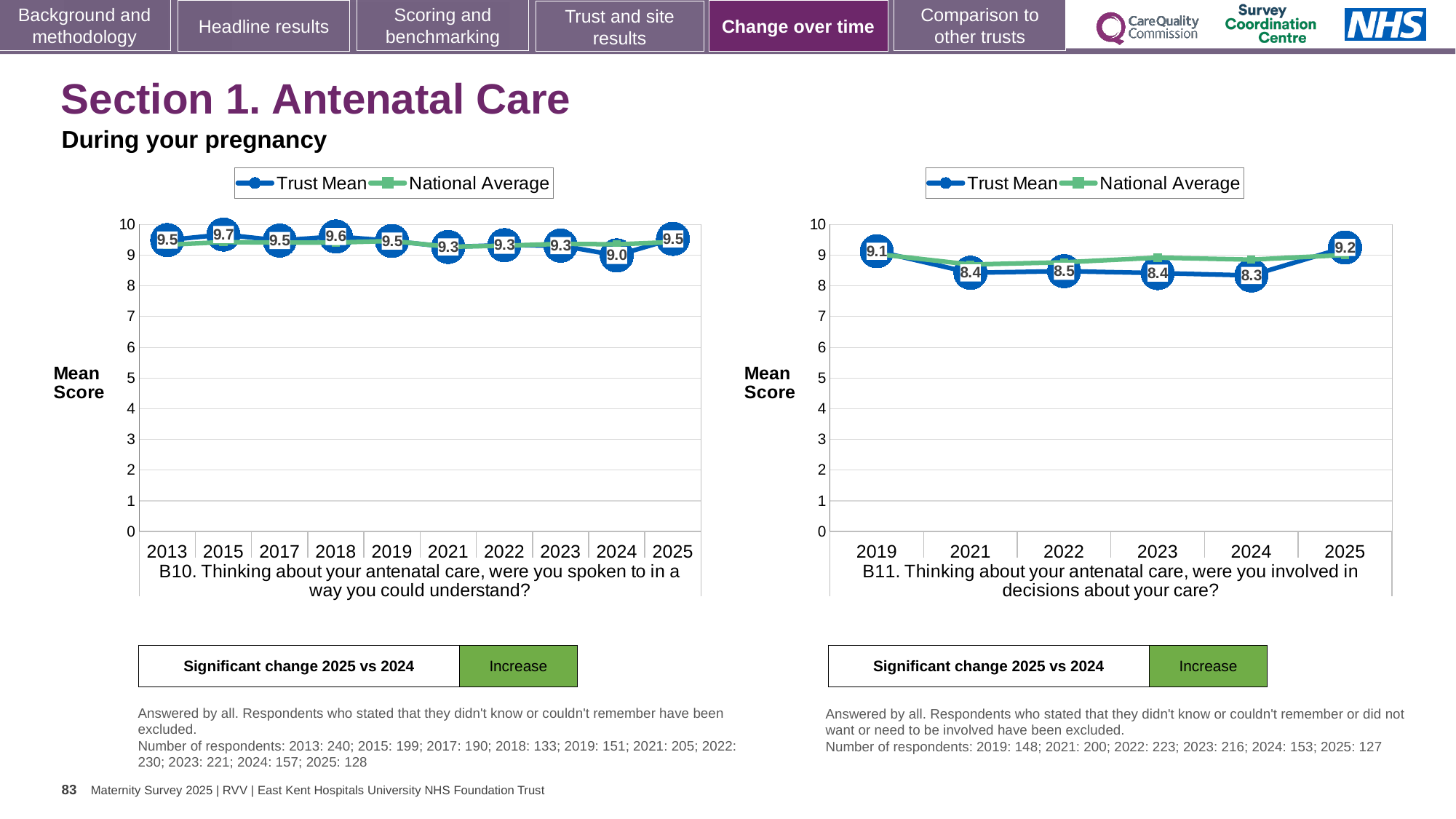
In the B11 chart on the right, which year has the lowest Trust Mean? 2024 In the B10 chart on the left, what is the Trust Mean for 2024? 9.0 In the B10 chart on the left, how many years are shown on the x axis? 10 In the B11 chart on the right, what is the difference between the Trust Mean for 2019 and 2021? 0.7 In the B10 chart on the left, what is the Trust Mean for 2015? 9.7 In the B11 chart on the right, what is the Trust Mean for 2025? 9.2 How many series does the legend of the B11 chart on the right list? 2 What kind of chart is the B10 chart on the left? Line chart In the B10 chart on the left, which year has the lowest Trust Mean? 2024 In the B11 chart on the right, is the Trust Mean for 2022 larger than the Trust Mean for 2024? Yes, 2022 (8.5) is larger than 2024 (8.3) In the B10 chart on the left, which year has the highest Trust Mean? 2015 In the B10 chart on the left, what is the difference between the Trust Mean for 2025 and 2024? 0.5